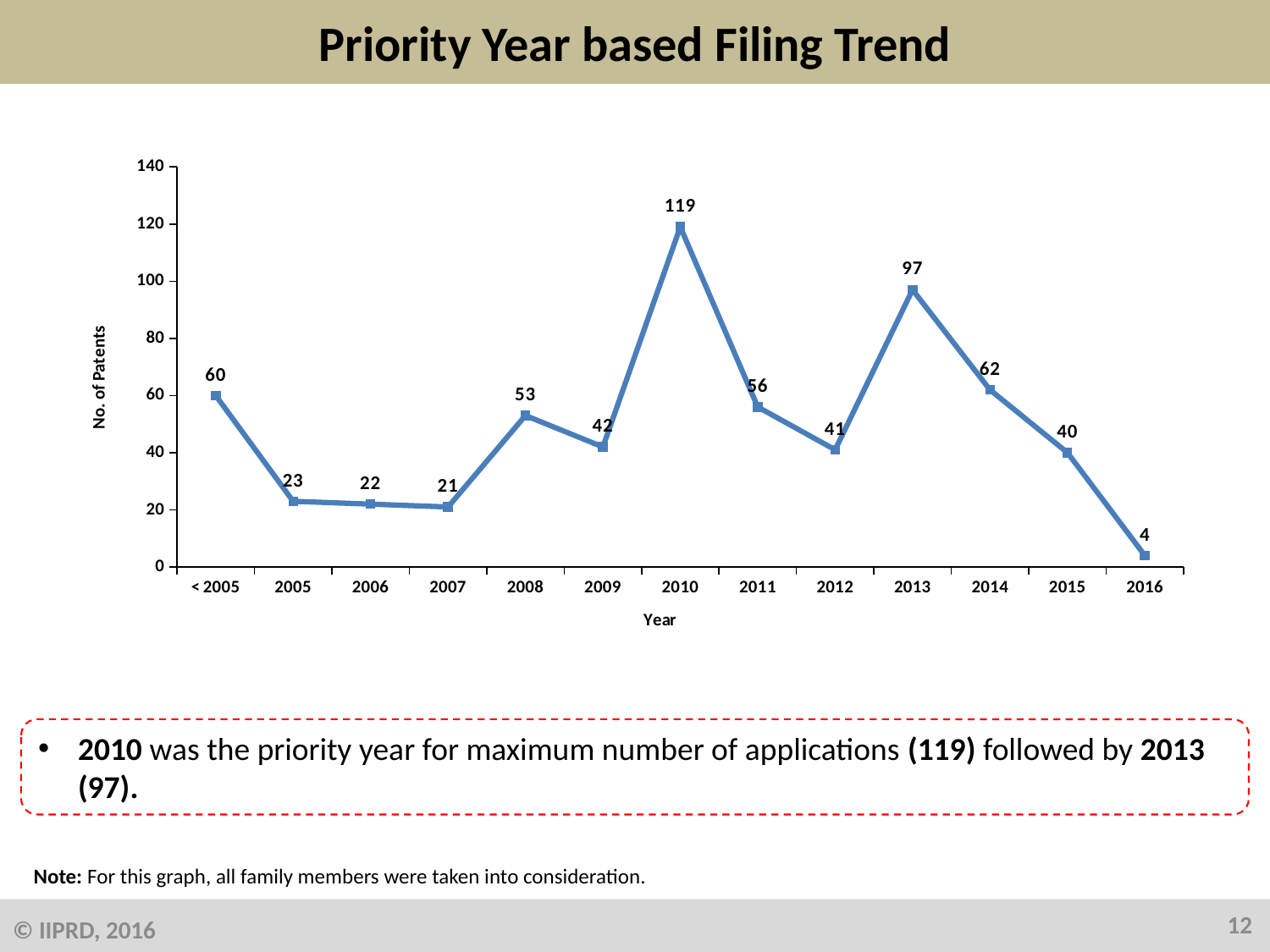
What is the number of patents for priority year 2010? 119 How many year categories are shown on the x axis? 13 Which year has the highest number of patents? 2010 What type of chart is shown on the slide? line chart Which year has the lowest number of patents? 2016 What is the difference in number of patents between 2010 and 2013? 22 What is the number of patents for priority year 2008? 53 Is the value for 2013 greater or less than 80? greater What is the number of patents for the '< 2005' category? 60 What is the difference in number of patents between 2014 and 2015? 22 Which year has more patents, 2011 or 2012? 2011 Do the values rise or fall from 2013 to 2016? fall